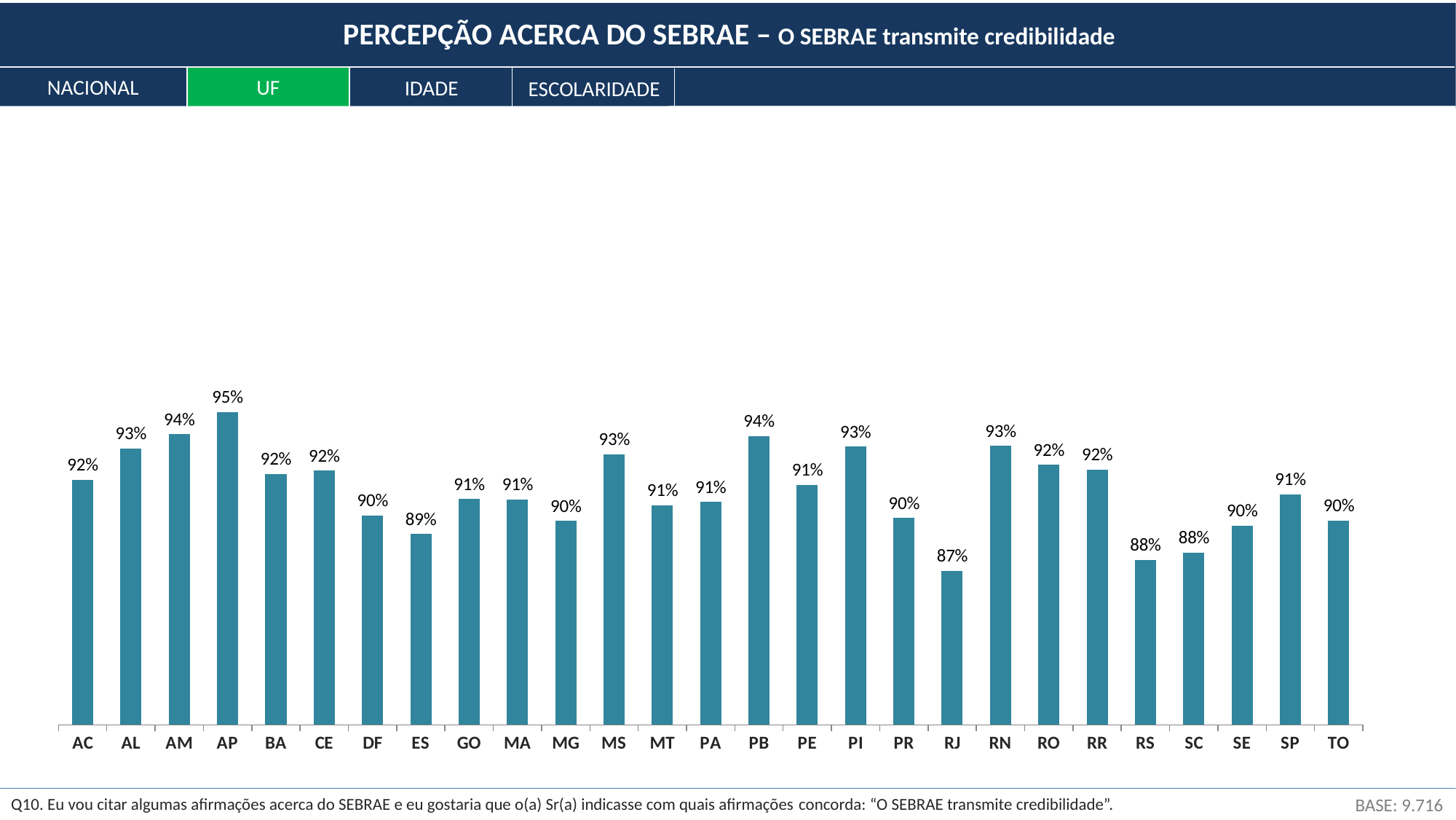
Which has a larger value, RS or RN? RN How many UFs are shown on the x axis? 27 Which has a larger value, MS or MT? MS What is the value for PB? 94% Which UF has the lowest value? RJ What is the value for RJ? 87% What kind of chart is shown on the slide? Bar chart What is the value for AP? 95% What is the difference between the values for AP and RJ? 8% What is the value for SC? 88% Which UF has the highest value? AP What is the difference between the values for AM and ES? 5%